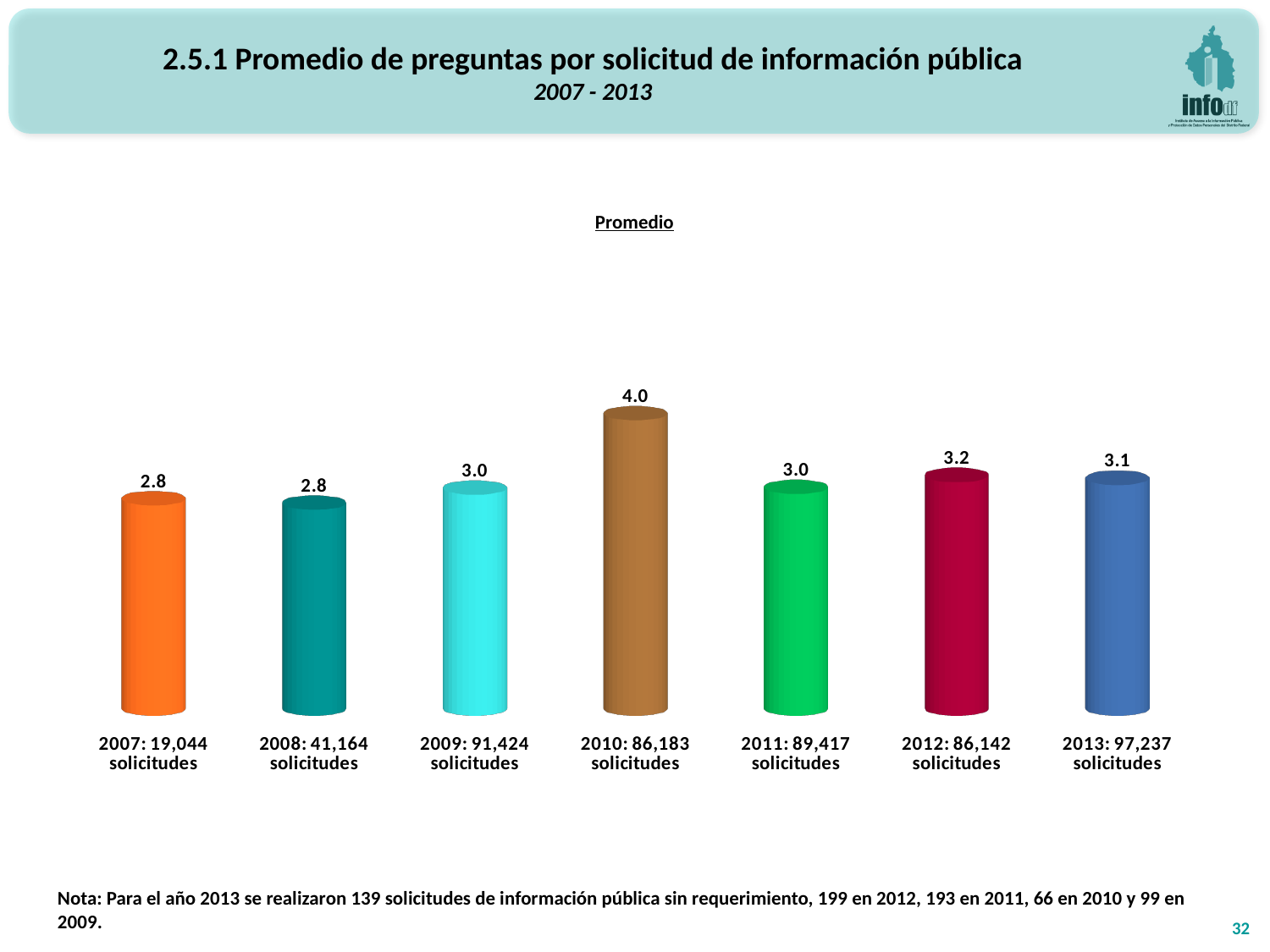
Which is larger, the Promedio value for 2012 or for 2011? 2012 Which year has the highest Promedio value? 2010 How many years (bars) are shown in the chart? 7 What is the Promedio value shown for 2013? 3.1 What is the difference between the Promedio values for 2010 and 2009? 1.0 What is the Promedio value shown for 2007? 2.8 What is the average number of questions per request (Promedio) for 2010? 4.0 How many solicitudes are listed in the category label for 2013? 97,237 What is the difference between the Promedio values for 2012 and 2013? 0.1 What kind of chart is shown on the slide? Bar chart What is the title shown above the chart? Promedio What is the Promedio value shown for 2012? 3.2